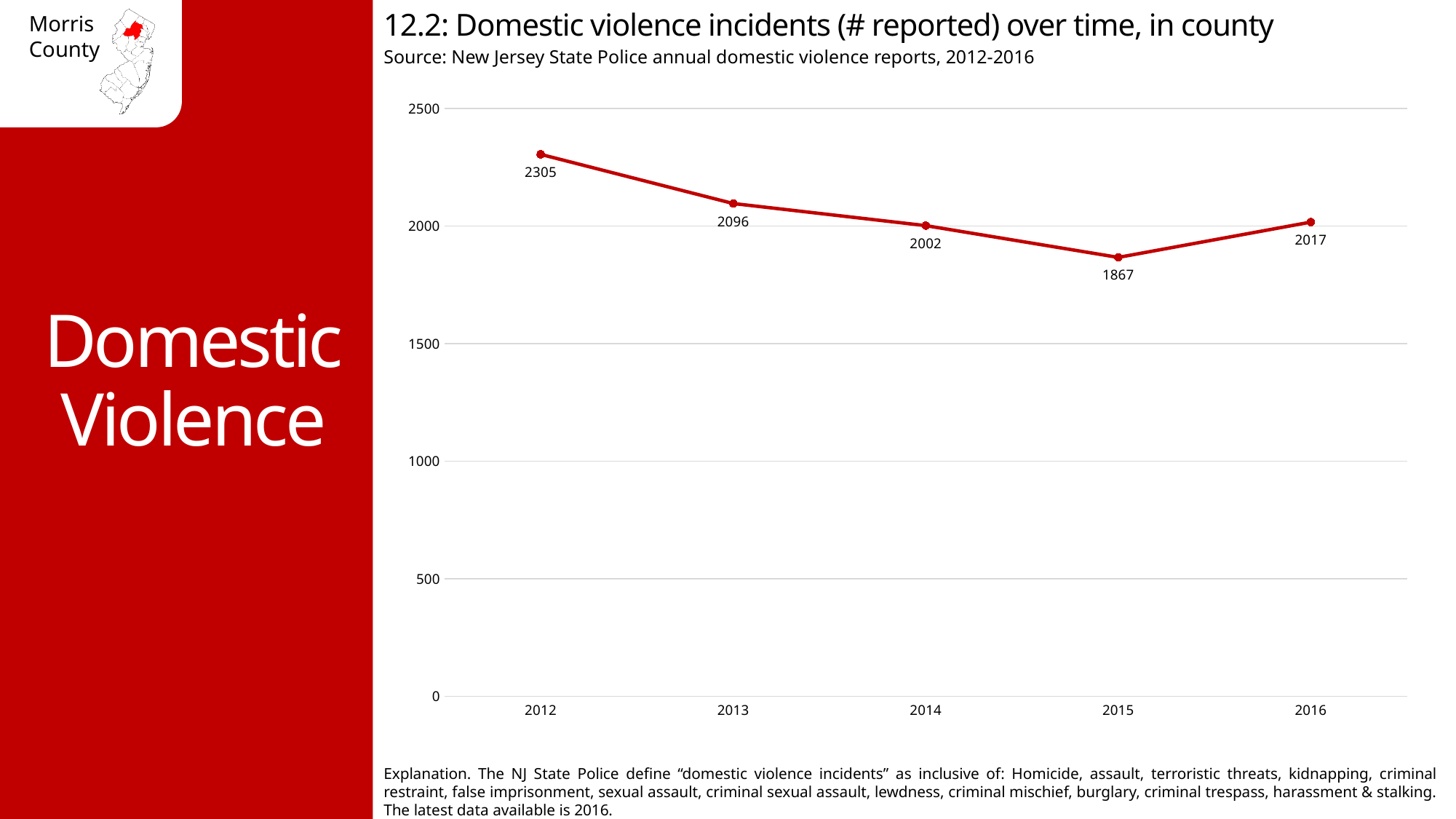
What is the overall trend in reported incidents from 2012 to 2015? falling What was the number of reported domestic violence incidents in 2016? 2017 How many years are plotted on the chart? 5 Which year had more reported incidents, 2014 or 2016? 2016 What is the difference in reported incidents between 2016 and 2015? 150 Which year had the lowest number of reported domestic violence incidents? 2015 Which year had the highest number of reported domestic violence incidents? 2012 What was the number of reported domestic violence incidents in 2015? 1867 What was the number of reported domestic violence incidents in 2012? 2305 What is the difference in reported incidents between 2012 and 2013? 209 Is the value for 2015 greater or less than 2000? less What kind of chart is shown on the slide? line chart